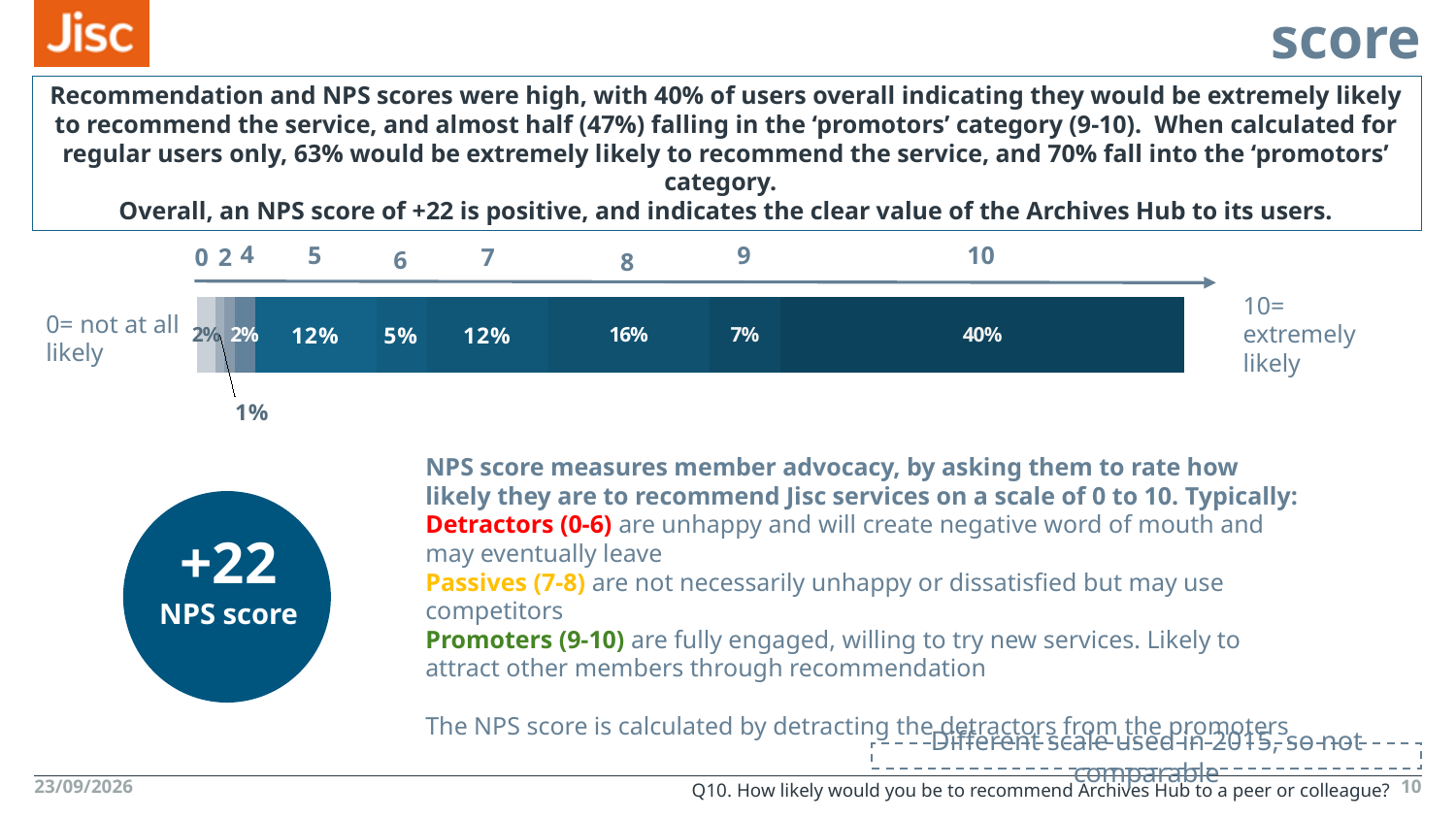
What percentage of users gave a rating of 10 (extremely likely) in the recommendation bar chart? 40% What is the difference in percentage points between the share of users rating 10 and the share rating 8? 24 What percentage of users gave a rating of 5 in the recommendation bar chart? 12% What kind of chart is used to show the distribution of recommendation ratings? Stacked bar chart What percentage of users gave a rating of 9 in the recommendation bar chart? 7% What NPS score is shown in the circle on the slide? +22 Which rating has a larger share of users: 8 or 9? 8 What is the combined percentage of users who gave a rating of 9 or 10? 47% What percentage of users gave a rating of 8 in the recommendation bar chart? 16% What percentage of users gave a rating of 6 in the recommendation bar chart? 5% Which rating has the largest share of users in the recommendation bar chart? 10